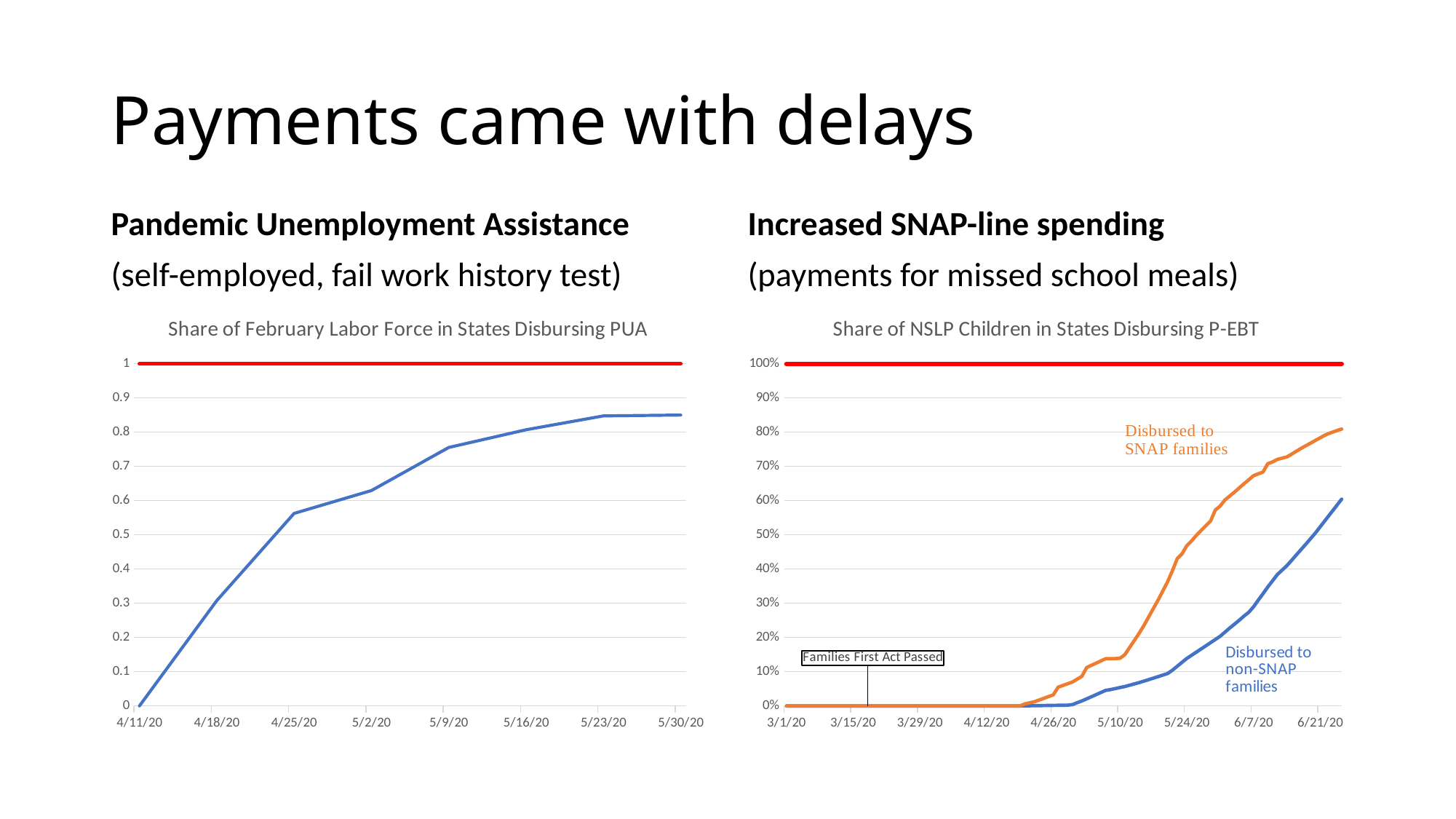
In the 'Share of NSLP Children in States Disbursing P-EBT' chart, is the value for 'Disbursed to non-SNAP families' on 5/24/20 greater or less than 20%? less In the 'Share of February Labor Force in States Disbursing PUA' chart, what is the value on 4/11/20? 0 In the 'Share of February Labor Force in States Disbursing PUA' chart, is the value on 5/30/20 greater or less than 0.9? less In the 'Share of February Labor Force in States Disbursing PUA' chart, is the value on 4/25/20 greater or less than 0.5? greater In the 'Share of NSLP Children in States Disbursing P-EBT' chart, what is the value for 'Disbursed to SNAP families' on 3/1/20? 0% What kind of chart is the 'Share of February Labor Force in States Disbursing PUA' chart? line chart In the 'Share of February Labor Force in States Disbursing PUA' chart, do the values rise or fall from 4/11/20 to 5/30/20? rise In the 'Share of NSLP Children in States Disbursing P-EBT' chart, which series is higher on 6/7/20, 'Disbursed to SNAP families' or 'Disbursed to non-SNAP families'? Disbursed to SNAP families In the 'Share of NSLP Children in States Disbursing P-EBT' chart, what colour is the 'Disbursed to non-SNAP families' line? blue In the 'Share of NSLP Children in States Disbursing P-EBT' chart, what event does the annotation near the start of the x axis mark? Families First Act Passed How many series does the 'Share of NSLP Children in States Disbursing P-EBT' chart plot? 3